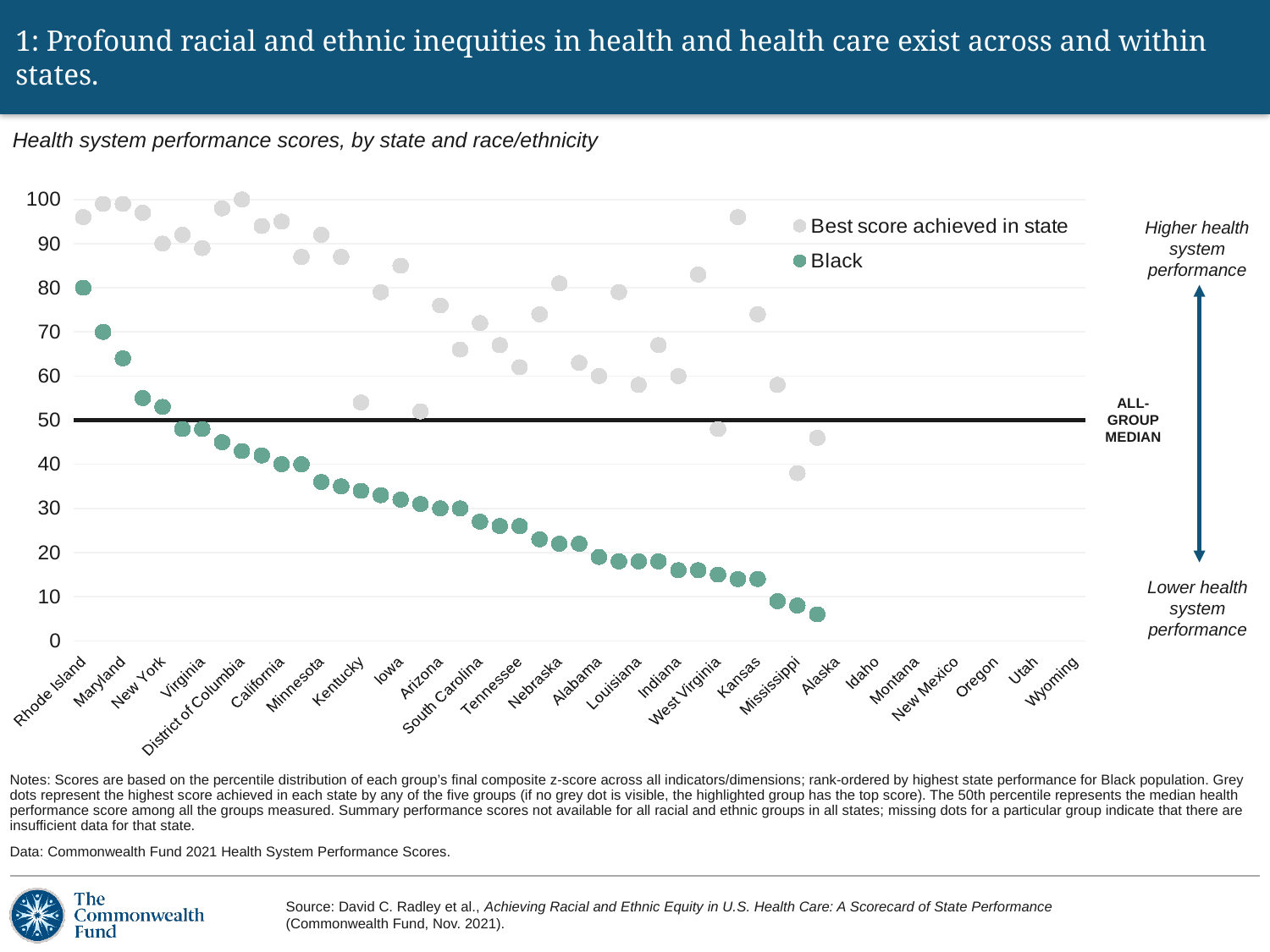
Which state has the highest Black score? Rhode Island Is the Black score for Alabama greater or less than 30? less How many series does the legend list? 2 Is the Black score for Minnesota greater or less than 40? less Is the Black score for Rhode Island greater or less than 70? greater What kind of chart is shown on the slide? Scatter (dot) chart What value does the horizontal black line labelled ALL-GROUP MEDIAN sit at? 50 Do the Black scores rise or fall moving from left to right along the x axis? fall What are the two series named in the legend? Best score achieved in state; Black